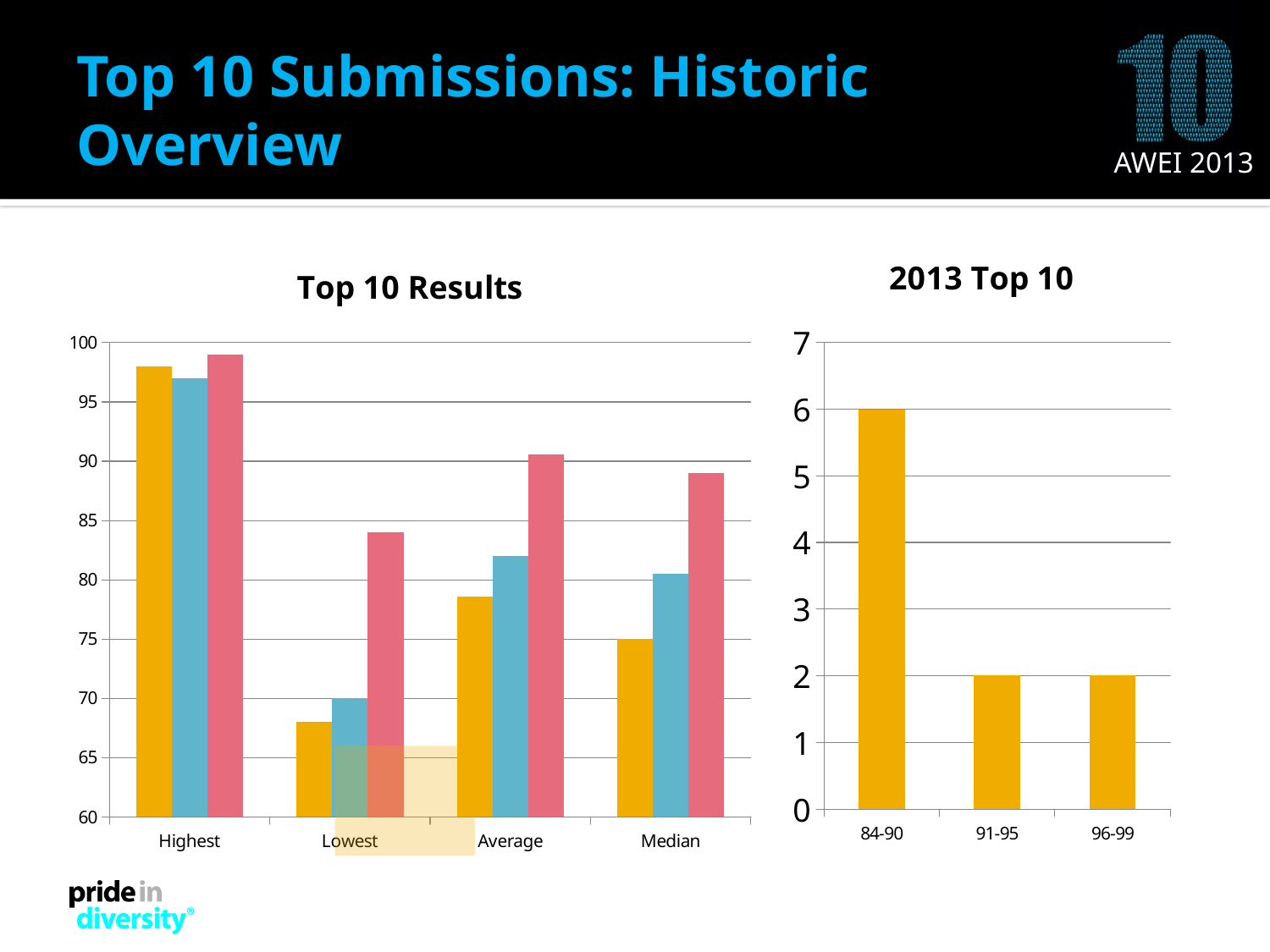
In the Top 10 Results chart, for the Average category, which bar is taller, the red bar or the yellow bar? red In the Top 10 Results chart, is the value of the yellow bar for Lowest greater or less than 70? less In the Top 10 Results chart, how many bars are shown for each category? 3 In the Top 10 Results chart, is the value of the red bar for Lowest greater or less than 80? greater What kind of chart is the Top 10 Results chart? bar chart In the 2013 Top 10 chart, what is the difference between the values for 84-90 and 96-99? 4 What kind of chart is the 2013 Top 10 chart? bar chart In the 2013 Top 10 chart, which category has the highest value? 84-90 In the Top 10 Results chart, how many categories are shown on the x axis? 4 In the 2013 Top 10 chart, what is the value for the 84-90 category? 6 In the 2013 Top 10 chart, what is the value for the 91-95 category? 2 In the 2013 Top 10 chart, how many categories are shown on the x axis? 3